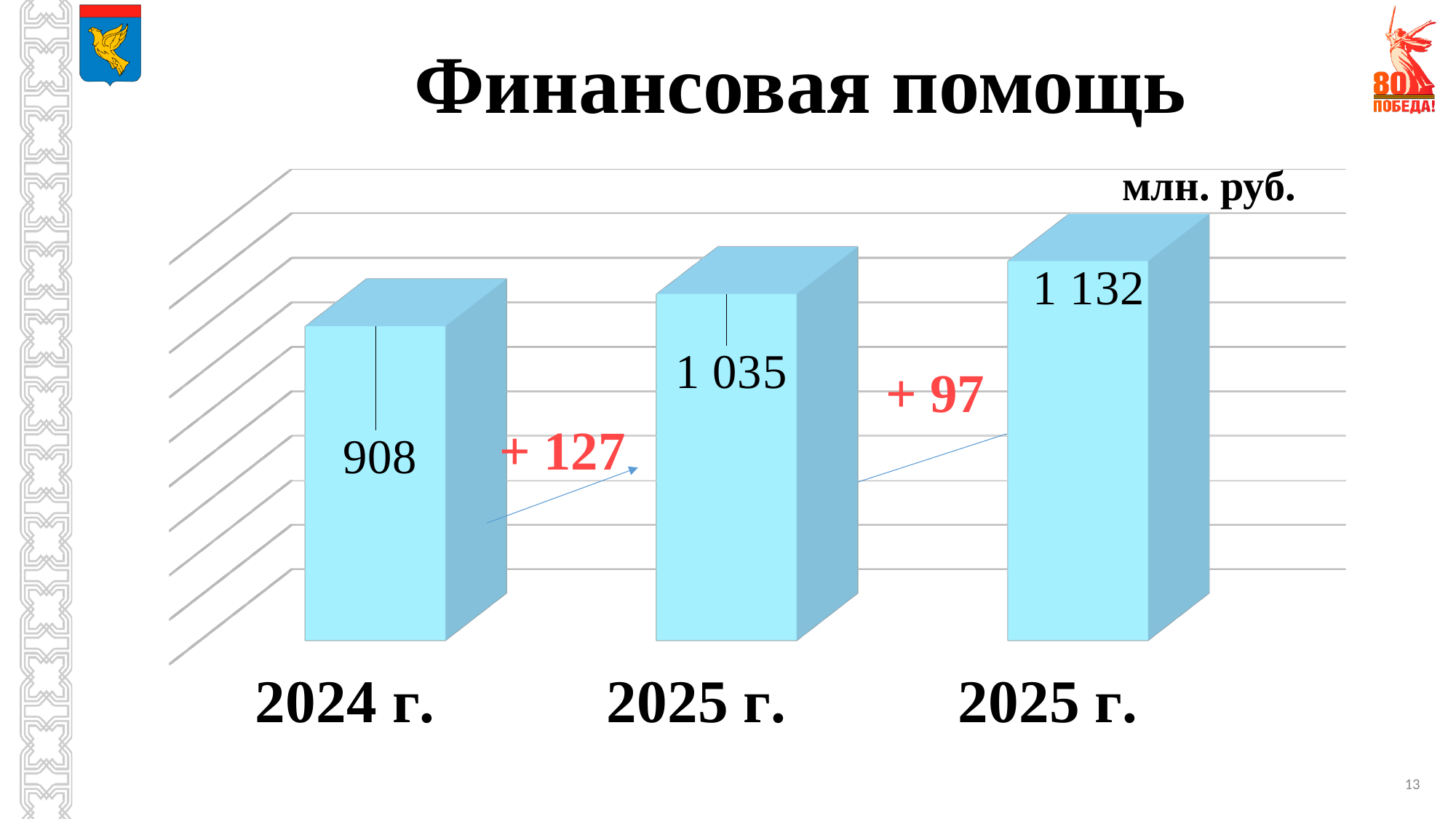
What is the value of the rightmost bar? 1 132 What is the value of the middle bar? 1 035 What is the difference between the rightmost bar and the middle bar? 97 Do the values rise or fall from left to right across the chart? rise Which bar has the lowest value? 2024 г. (908) Which bar has the highest value? the rightmost bar (1 132) Which is larger, the value for 2024 г. or the value of the middle bar? the middle bar (1 035) What is the value of the bar labelled 2024 г.? 908 What is the title of the chart on the slide? Финансовая помощь What type of chart is shown on the slide? bar chart How many bars does the chart show? 3 What is the difference between the middle bar and the 2024 г. bar? 127